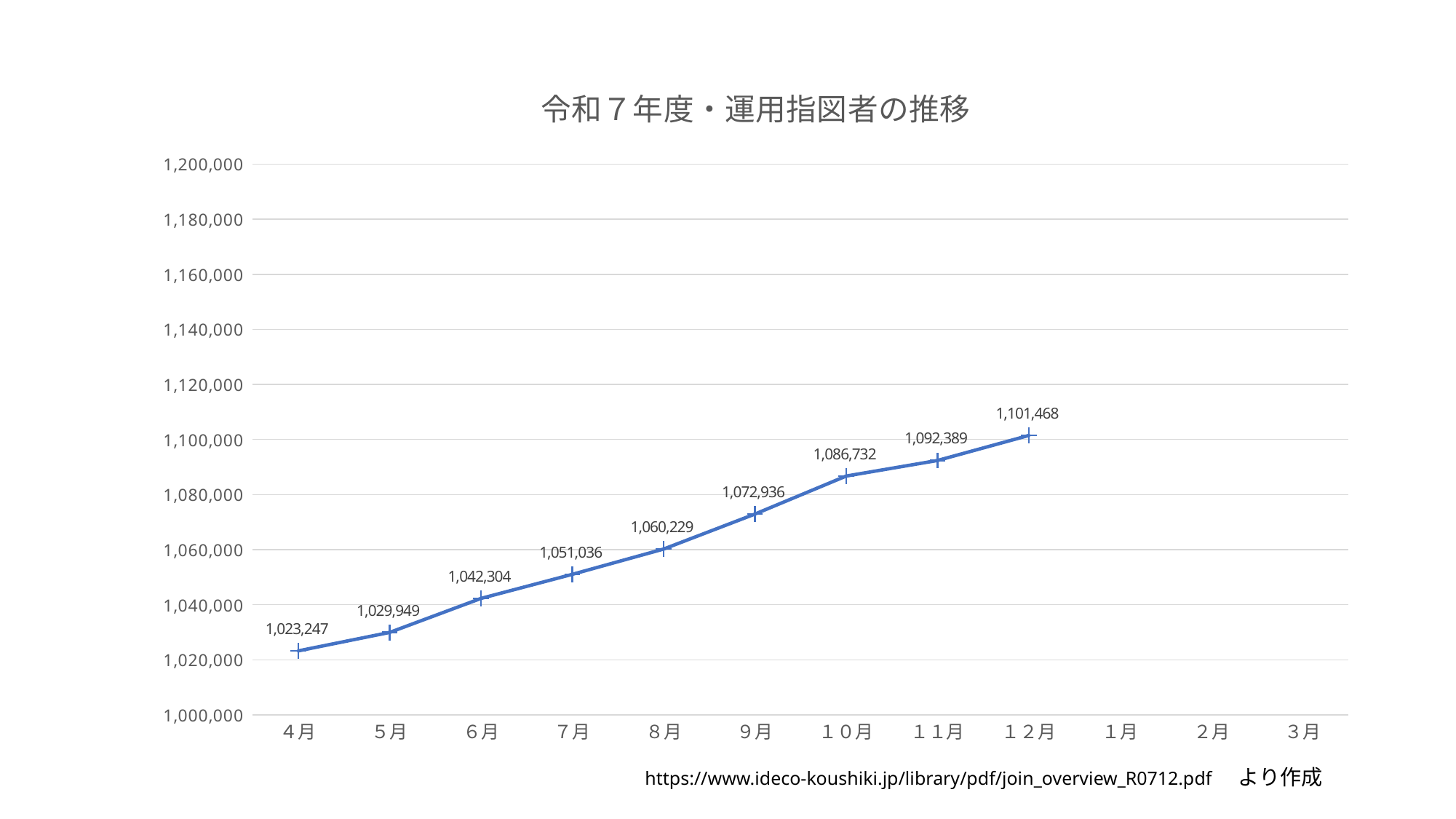
Which month has the highest plotted value? 12月 How many data points are plotted on the line? 9 Which month has the lowest plotted value? 4月 What is the difference between the values for 10月 and 9月? 13,796 What is the value for 4月? 1,023,247 What kind of chart is shown? line chart What is the value for 12月? 1,101,468 What is the value for 9月? 1,072,936 Do the values rise or fall from 4月 to 12月? rise What is the difference between the values for 12月 and 4月? 78,221 Is the value for 11月 greater or less than 1,100,000? less Which is larger, the value for 7月 or the value for 8月? 8月